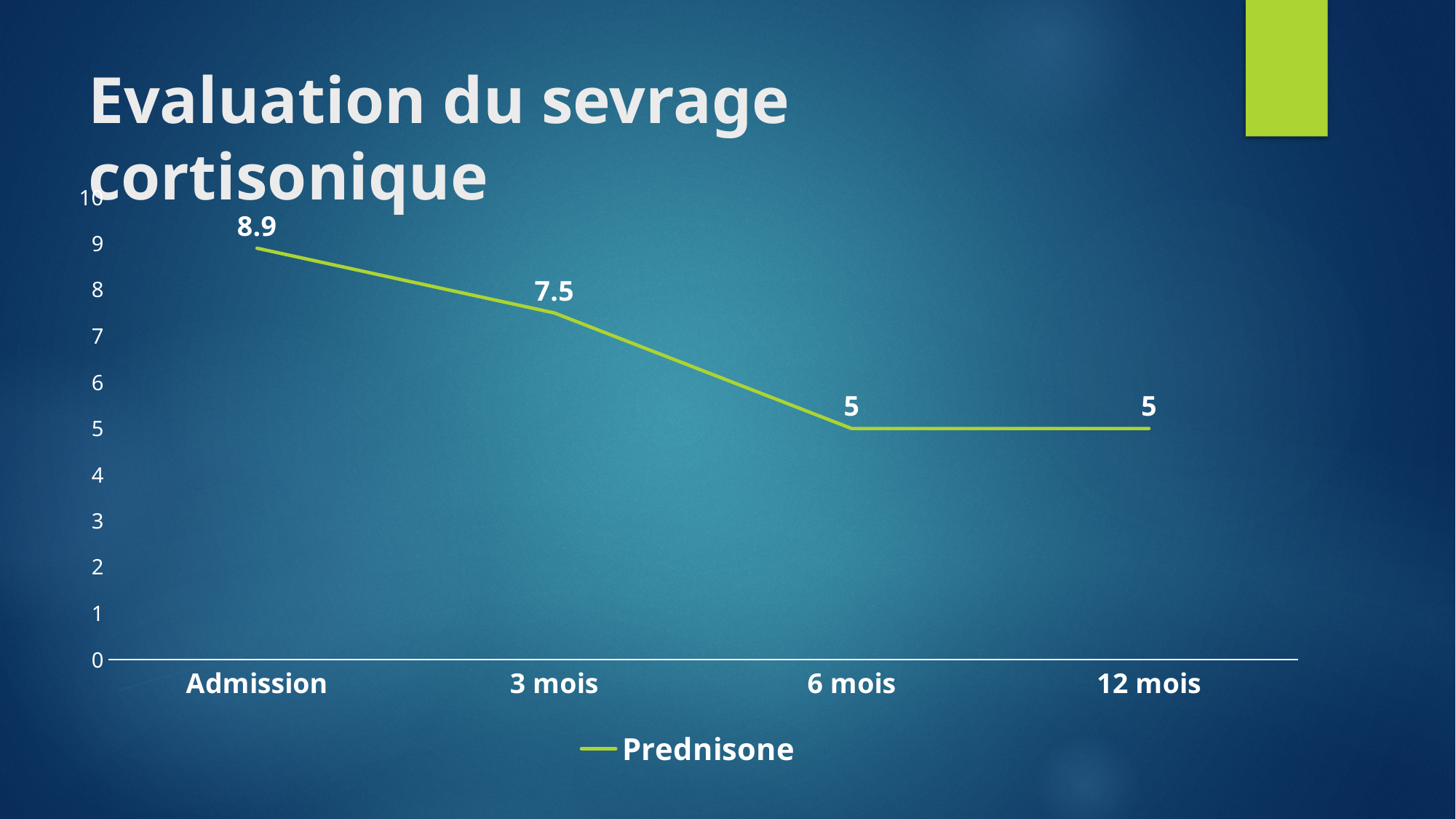
What is the Prednisone value at 3 mois? 7.5 Which is larger, the Prednisone value at Admission or at 6 mois? Admission What is the difference between the Prednisone value at Admission and at 3 mois? 1.4 What is the Prednisone value at 6 mois? 5 How many series does the legend list? 1 How many time points are plotted on the x axis? 4 What is the difference between the Prednisone value at 3 mois and at 6 mois? 2.5 What is the Prednisone value at Admission? 8.9 Do the Prednisone values rise or fall from Admission to 6 mois? Fall What kind of chart is shown on the slide? Line chart At which time point is the Prednisone value highest? Admission What is the Prednisone value at 12 mois? 5